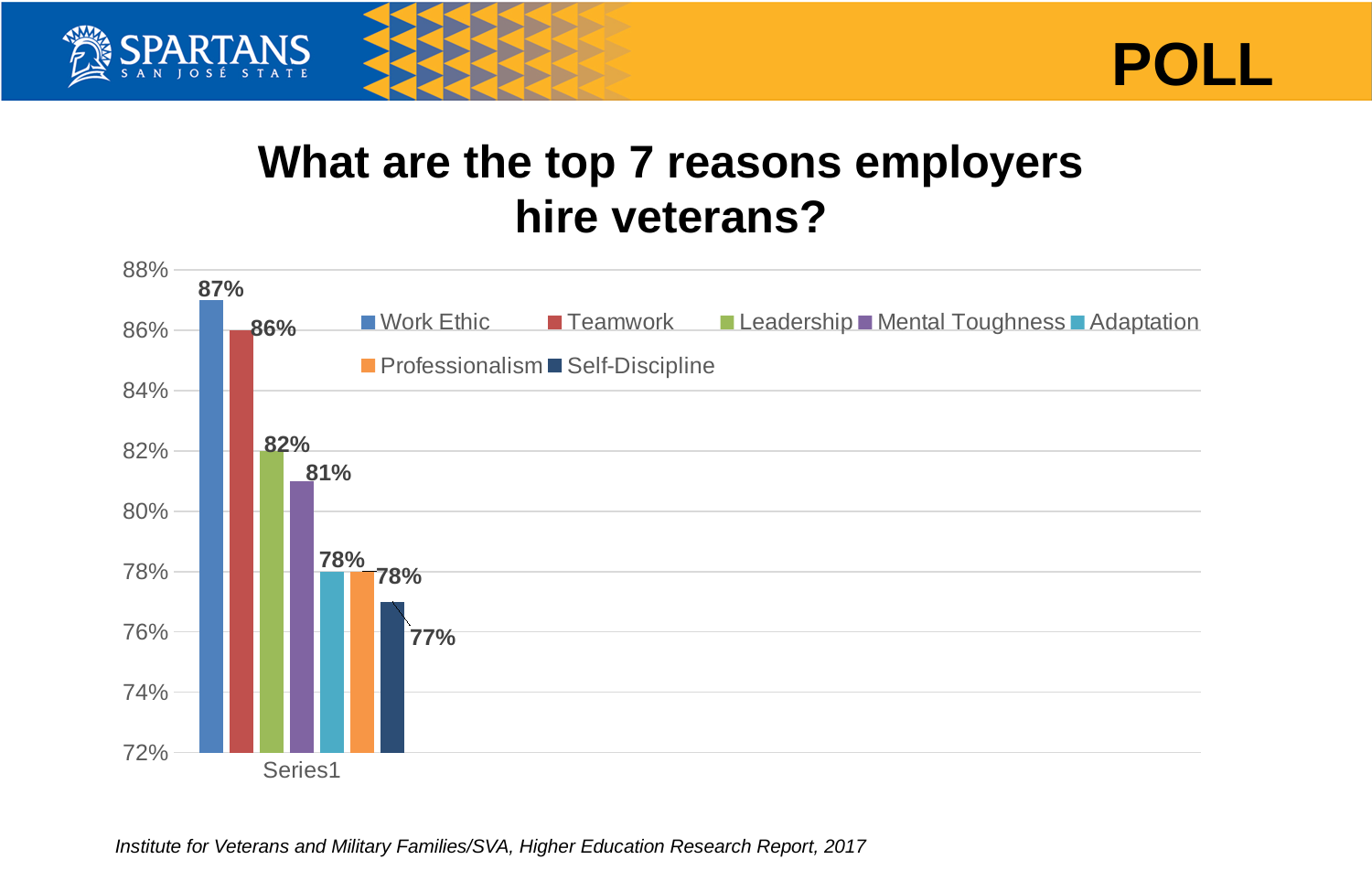
Which series has the lowest value? Self-Discipline What is the value for Teamwork? 86% What is the value for Leadership? 82% What is the title of the chart? What are the top 7 reasons employers hire veterans? What is the value for Mental Toughness? 81% Which series has the highest value? Work Ethic Which is larger, the value for Leadership or the value for Adaptation? Leadership How many series does the legend list? 7 What is the value for Self-Discipline? 77% What is the difference between the values for Work Ethic and Leadership? 5% What kind of chart is shown on the slide? bar chart What is the value for Work Ethic? 87%